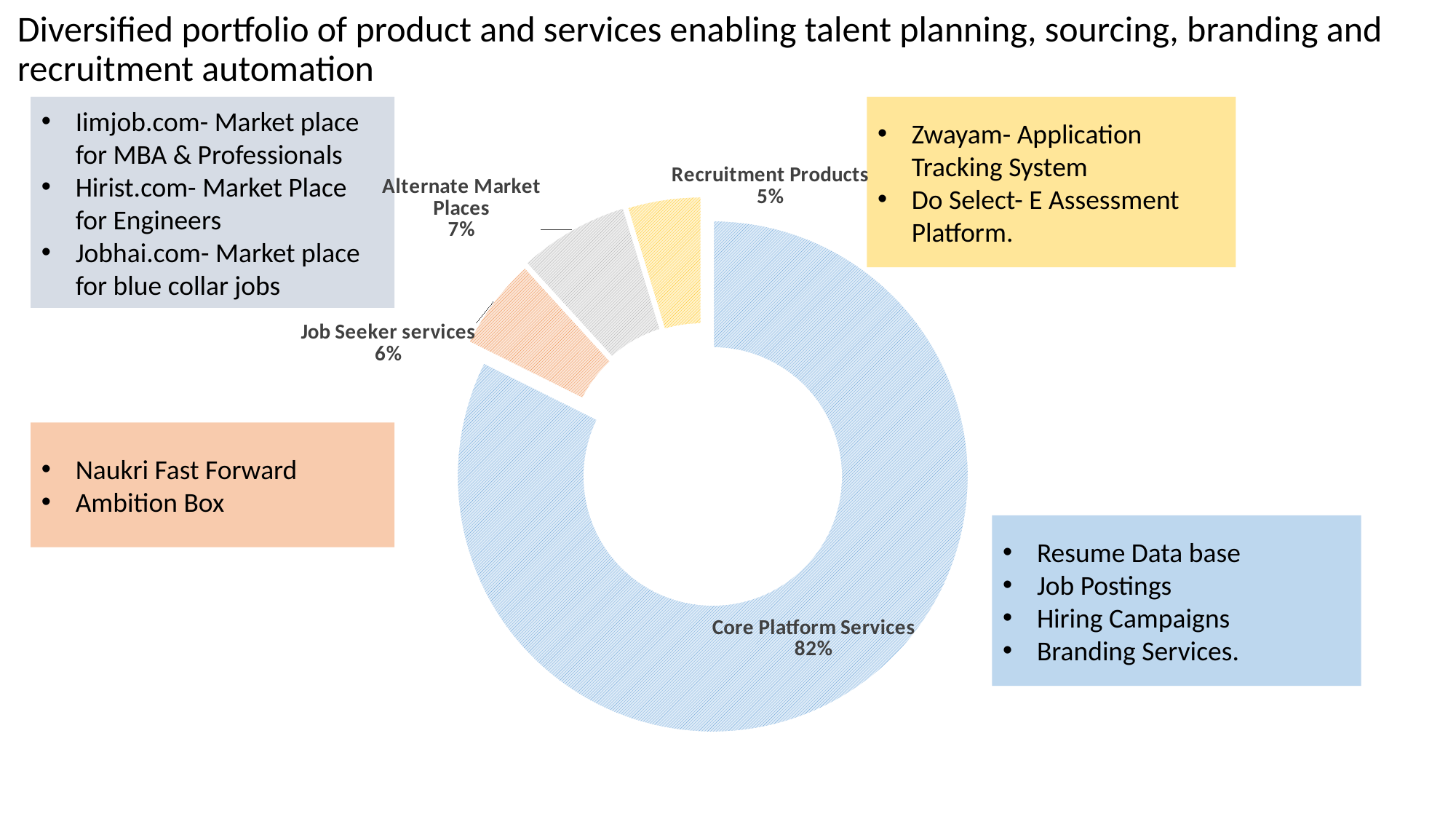
Which segment of the doughnut chart is the largest? Core Platform Services Which segment of the doughnut chart is the smallest? Recruitment Products What kind of chart is shown on the slide? Doughnut chart Which is larger in the doughnut chart: Alternate Market Places or Job Seeker services? Alternate Market Places What colour is the Core Platform Services segment of the doughnut chart? Blue What is the difference in percentage points between Core Platform Services and Alternate Market Places? 75 How many segments does the doughnut chart have? 4 What share of the doughnut chart is Recruitment Products? 5% What is the combined share of Alternate Market Places, Job Seeker services and Recruitment Products? 18% What share of the doughnut chart is Job Seeker services? 6% What share of the doughnut chart is Core Platform Services? 82% What share of the doughnut chart is Alternate Market Places? 7%